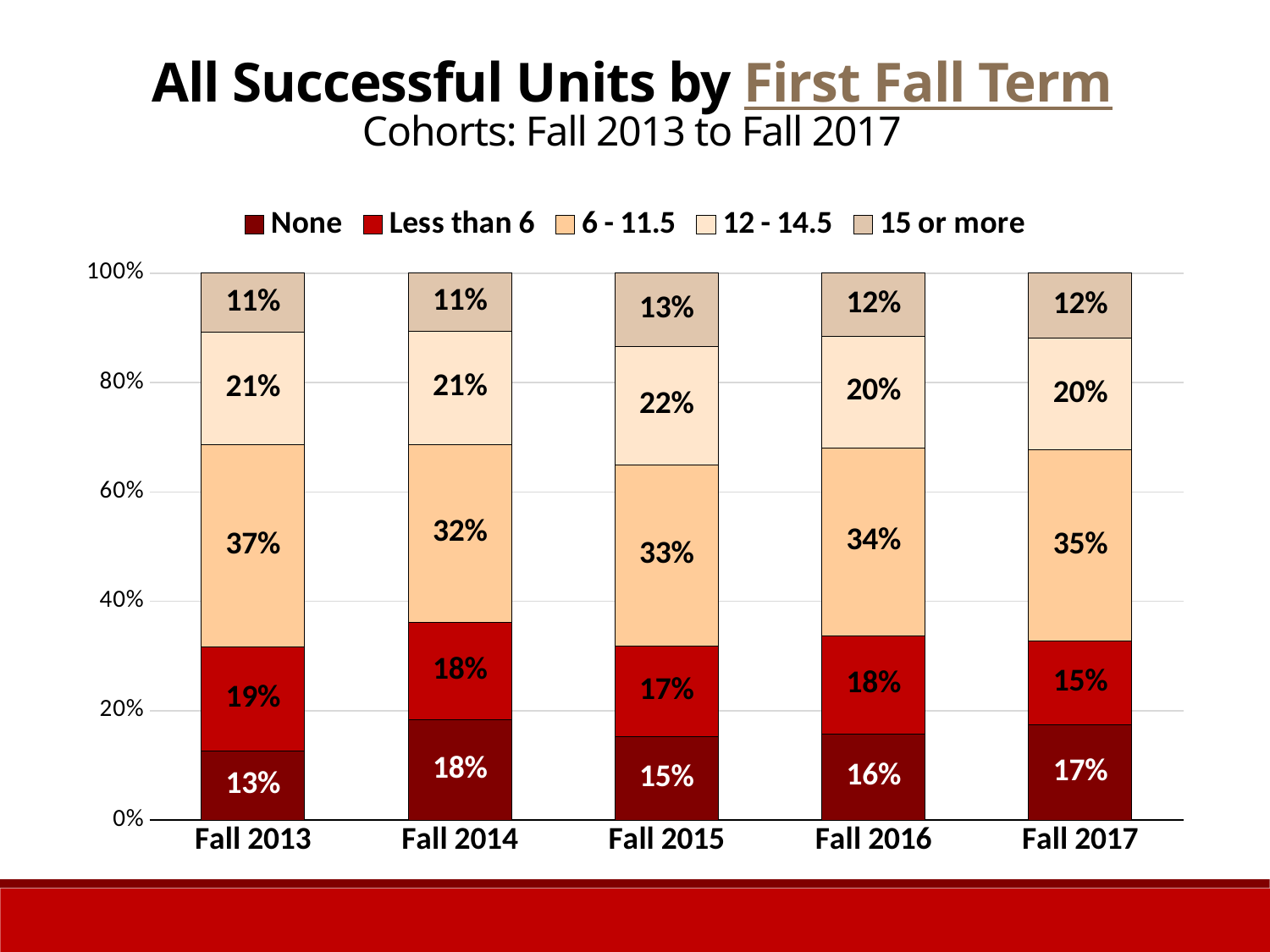
Do the 'None' values rise or fall from Fall 2015 to Fall 2017? Rise How many cohorts are shown on the x axis? 5 Which cohort has the lowest value for 'None'? Fall 2013 Which is larger: the 'Less than 6' value for Fall 2013 or for Fall 2017? Fall 2013 What kind of chart is shown on the slide? Stacked bar chart What percentage of the Fall 2013 cohort had 'None' successful units? 13% What is the difference between the 'None' values for Fall 2014 and Fall 2013? 5% What is the value for '15 or more' in Fall 2015? 13% Which cohort has the highest value for '6 - 11.5'? Fall 2013 How many series does the legend list? 5 What is the value for '6 - 11.5' in Fall 2017? 35% What is the value for 'Less than 6' in Fall 2016? 18%